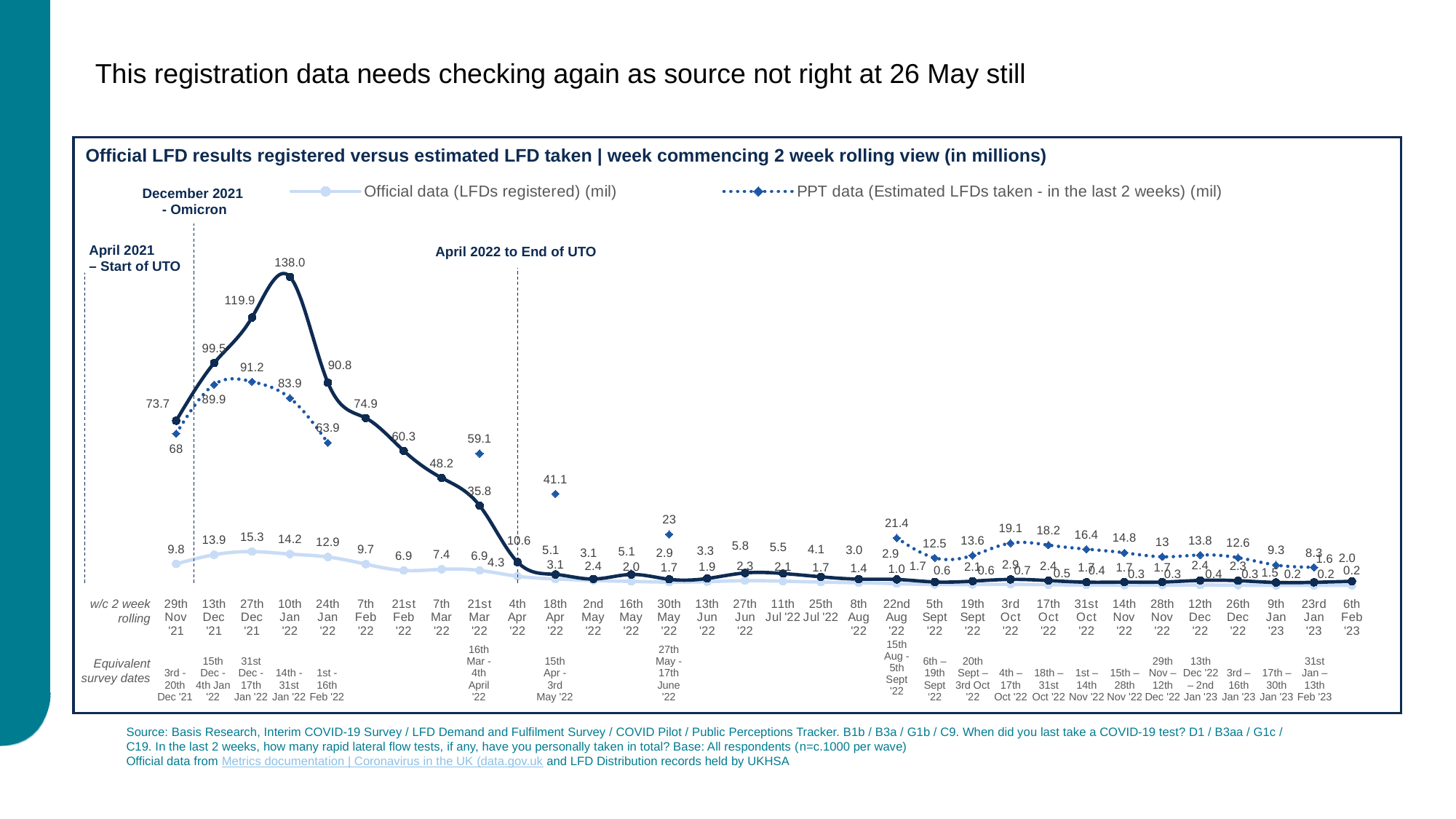
What kind of chart is shown on the slide? line chart What event does the annotation for December 2021 on the chart refer to? Omicron How many week-commencing categories are shown on the x axis? 32 What is the PPT data (Estimated LFDs taken) value for the week commencing 27th Dec '21? 91.2 Which week has the larger PPT data value: 22nd Aug '22 or 5th Sept '22? 22nd Aug '22 What is the PPT data (Estimated LFDs taken) value for the week commencing 21st Mar '22? 59.1 What is the highest value labelled anywhere on the chart? 138.0 What is the difference between the PPT data values for 21st Mar '22 (59.1) and 18th Apr '22 (41.1)? 18.0 What is the PPT data (Estimated LFDs taken) value for the week commencing 30th May '22? 23 How many series does the chart legend list? 2 What is the PPT data (Estimated LFDs taken) value for the week commencing 18th Apr '22? 41.1